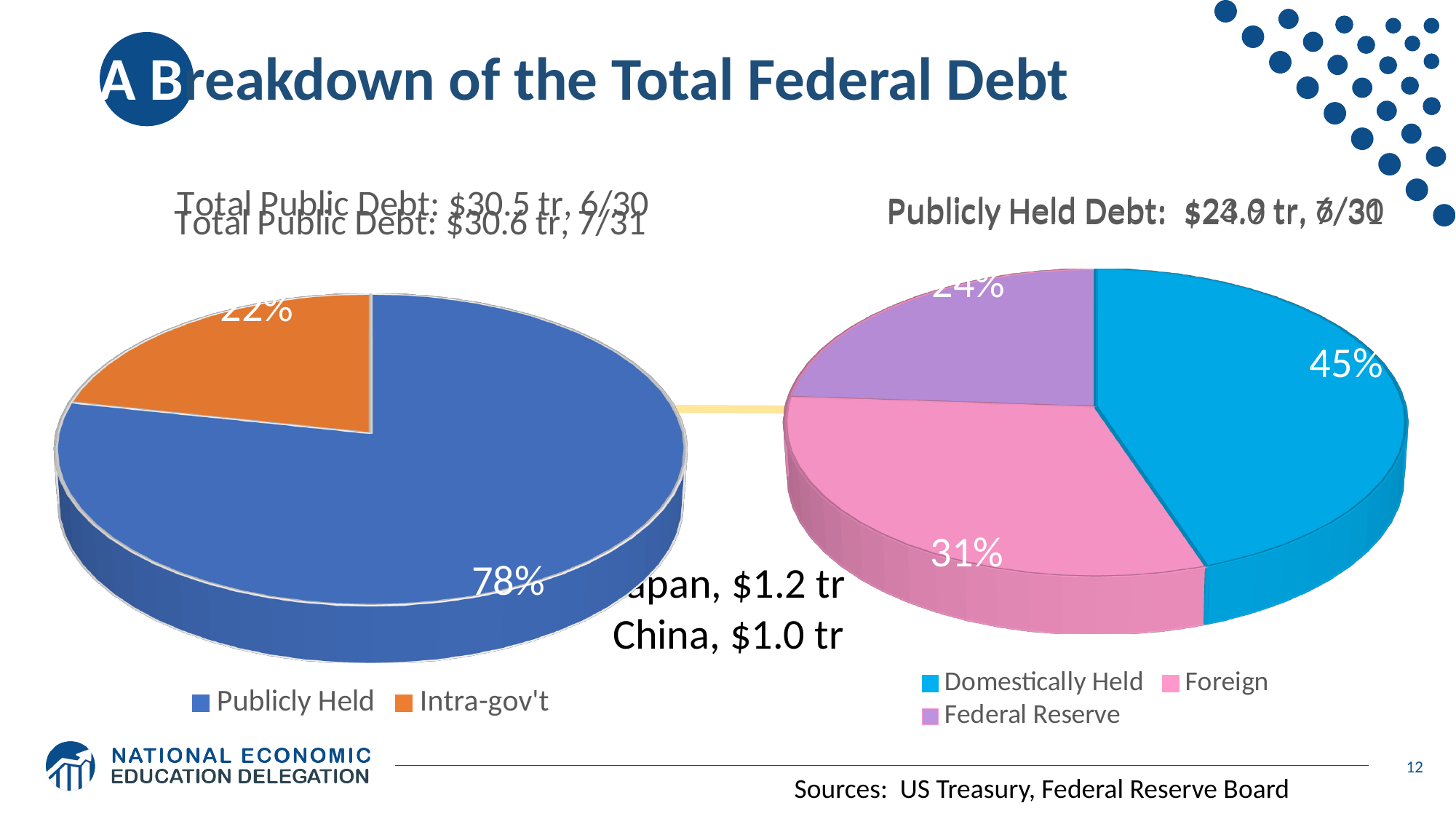
In the left pie chart, which category has the largest share? Publicly Held In the left pie chart, what share of the total public debt is Publicly Held? 78% In the right pie chart, which category has the smallest share? Federal Reserve How many categories does the legend of the left pie chart list? 2 In the right pie chart, which is larger: the Foreign share or the Domestically Held share? Domestically Held In the left pie chart, what share of the total public debt is Intra-gov't? 22% In the right pie chart, what share of publicly held debt is Foreign? 31% In the right pie chart, what share of publicly held debt is held by the Federal Reserve? 24% What kind of chart is the left chart on the slide? pie chart How many categories does the legend of the right pie chart list? 3 In the right pie chart, what is the difference in percentage points between the Domestically Held share and the Foreign share? 14 In the right pie chart, what share of publicly held debt is Domestically Held? 45%